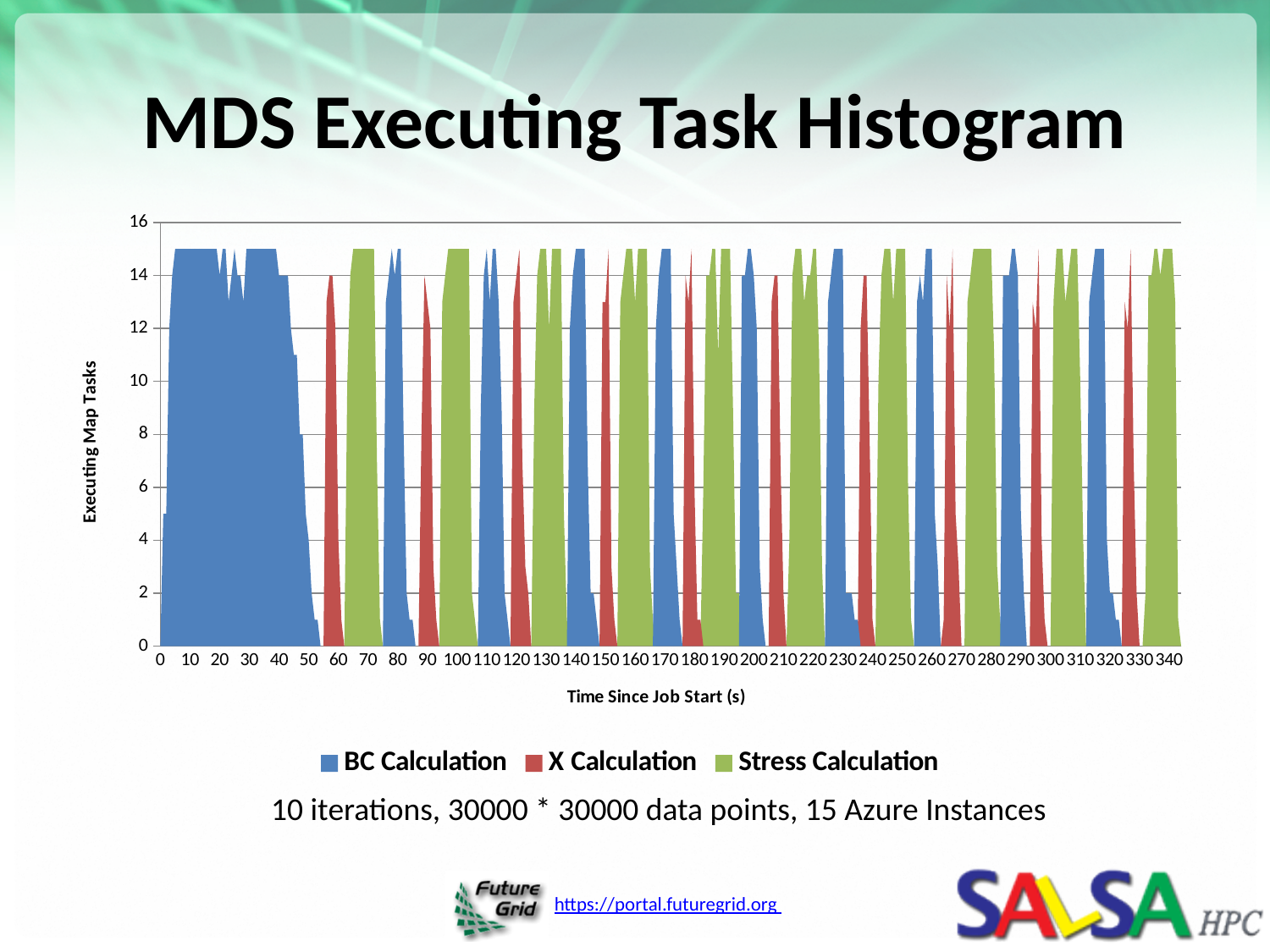
What is the last tick value shown on the horizontal axis? 340 How many series does the legend list? 3 Does the BC Calculation series rise or fall between 40 and 50 seconds? fall What are the three series named in the legend? BC Calculation, X Calculation, Stress Calculation What is the label of the vertical axis? Executing Map Tasks Is the value for BC Calculation at 20 seconds greater or less than 10? greater What is the highest value shown on the vertical axis? 16 What is the label of the horizontal axis? Time Since Job Start (s) What is the title of the chart? MDS Executing Task Histogram What kind of chart is shown on the slide? Area chart Which series is plotted first along the x axis, starting at 0 seconds? BC Calculation